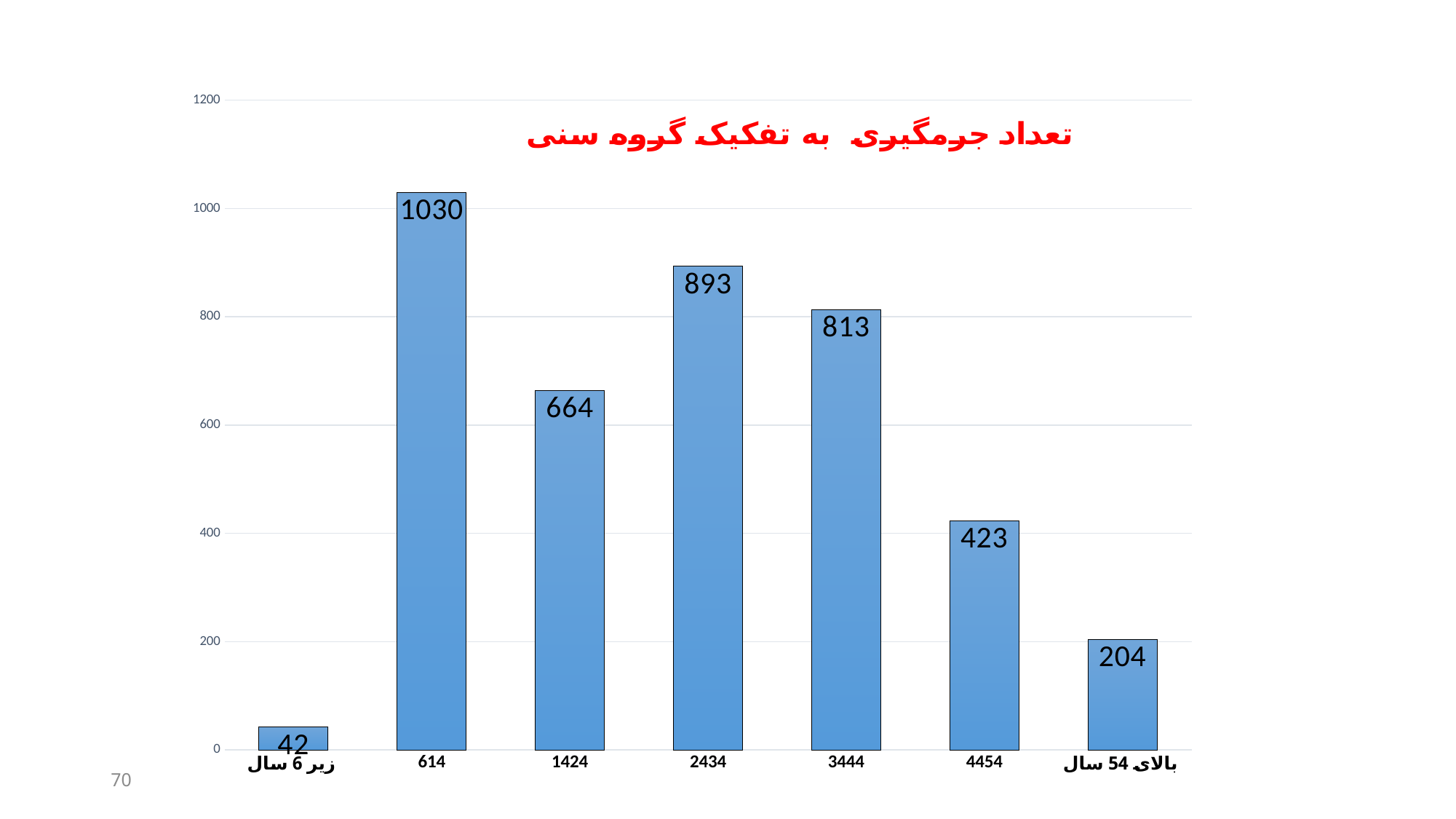
Is the value for 3444 greater or less than 800? greater What is the value for the category labelled 2434? 893 What is the difference between the values for 2434 and 3444? 80 Which is larger, the value for 1424 or the value for 4454? 1424 Which category has the highest value? 614 How many categories are shown on the x axis? 7 What kind of chart is shown on the slide? bar chart What is the value for the category labelled 614? 1030 What is the value for the category labelled 'زیر 6 سال'? 42 What is the title of the chart? تعداد جرمگیری به تفکیک گروه سنی Which category has the lowest value? زیر 6 سال What is the value for the category labelled 'بالای 54 سال'? 204